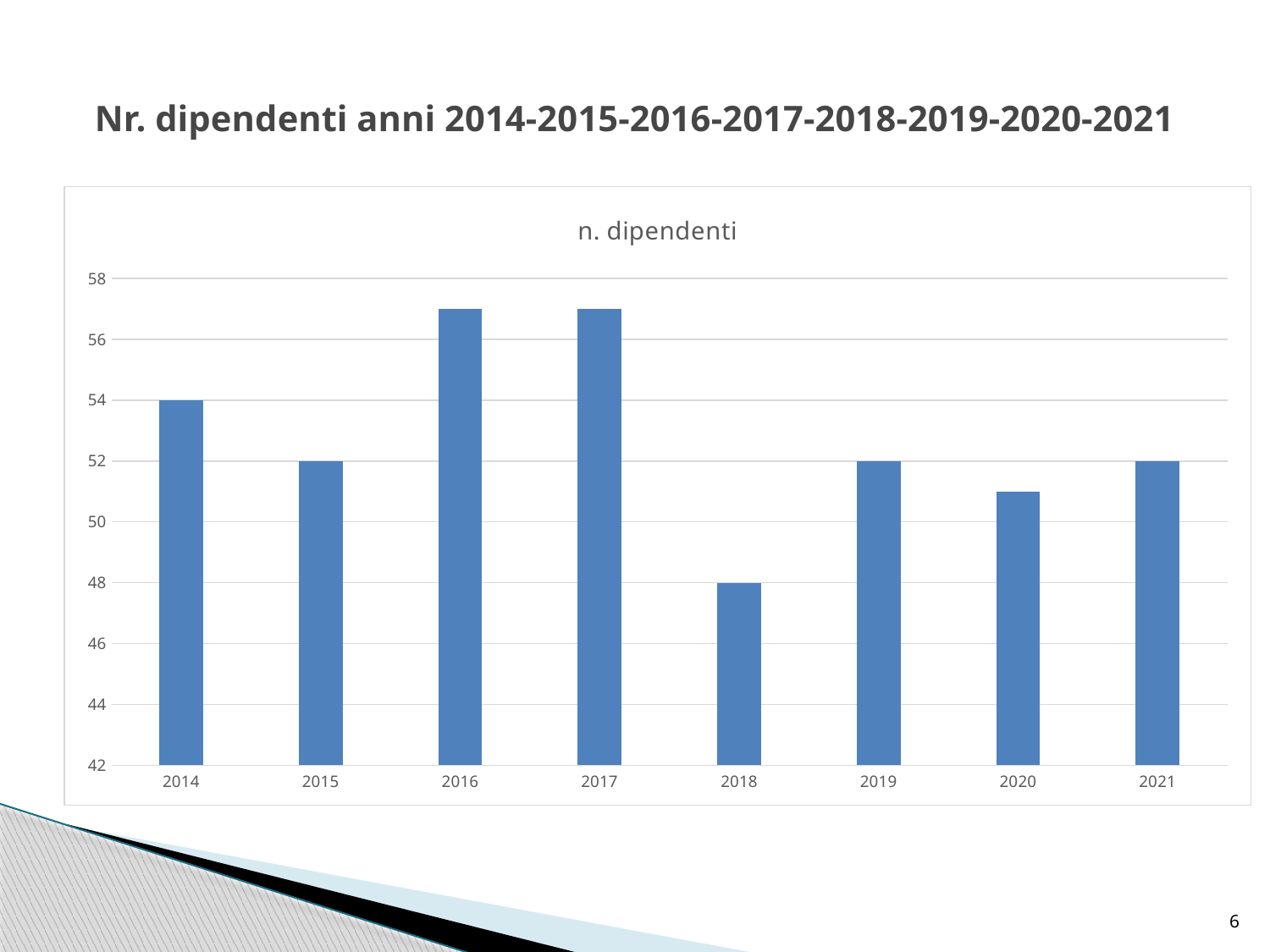
What is the value for 2021? 52 What is the title shown inside the chart area? n. dipendenti Which year has the lowest value? 2018 What is the value for 2015? 52 What is the value for 2014? 54 Is the value for 2016 greater or less than 56? greater How many years are shown on the x axis? 8 Is the value for 2020 greater or less than 52? less Which is larger, the value for 2014 or the value for 2019? 2014 What is the difference between the values for 2014 and 2018? 6 What is the value for 2018? 48 What kind of chart is shown? bar chart